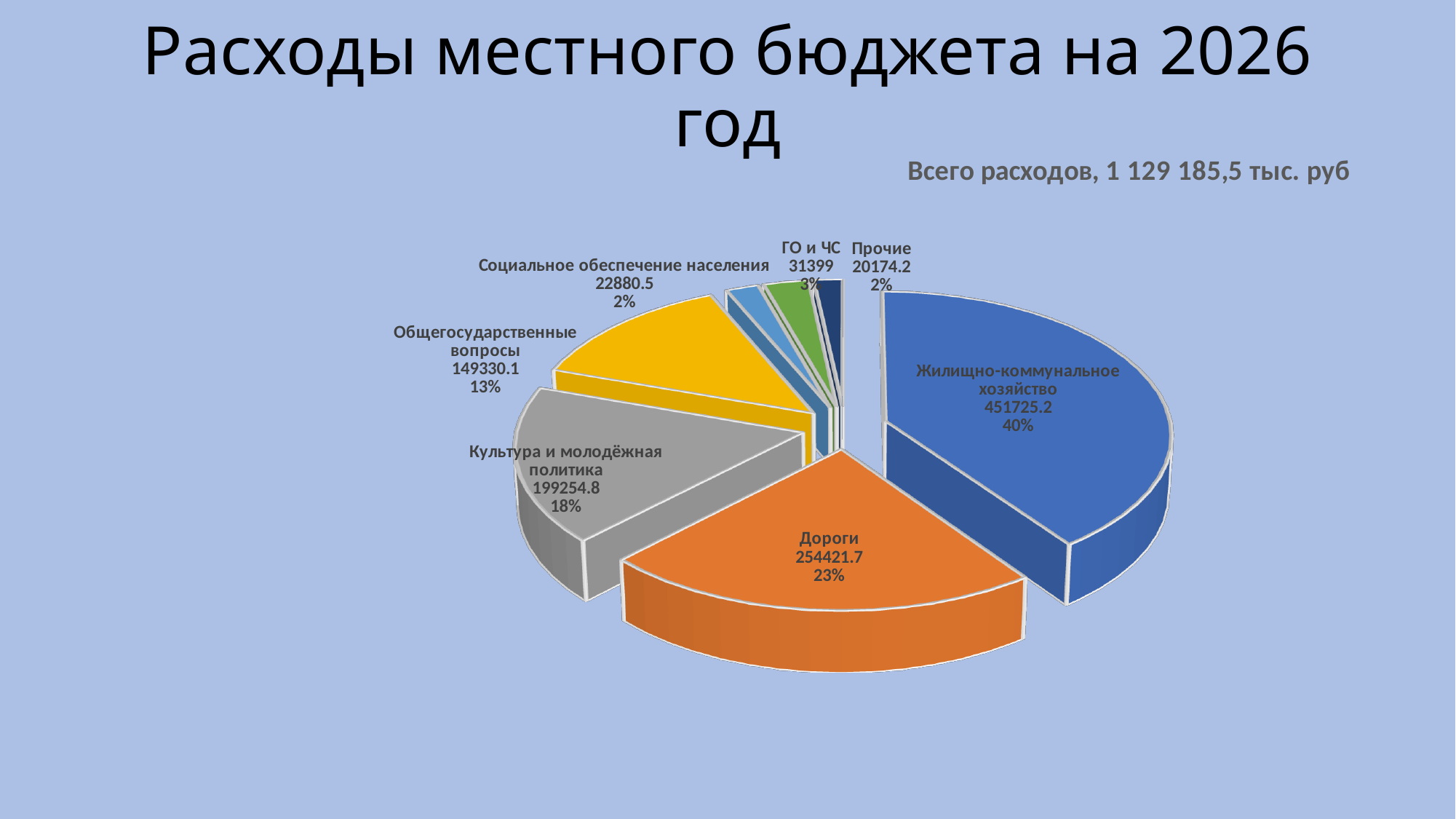
What is the difference between the values for Дороги and Культура и молодёжная политика? 55166.9 What is the title of the slide? Расходы местного бюджета на 2026 год Which is larger, the value for ГО и ЧС or the value for Прочие? ГО и ЧС What percentage share does the Дороги slice have? 23% What percentage share does Общегосударственные вопросы have? 13% What is the value shown for ГО и ЧС? 31399 What kind of chart is shown on the slide? Pie chart What is the value shown for Жилищно-коммунальное хозяйство? 451725.2 What total expenditure amount is stated on the slide? 1 129 185,5 тыс. руб Which category has the largest slice of the pie? Жилищно-коммунальное хозяйство What is the difference between the values for Жилищно-коммунальное хозяйство and Дороги? 197303.5 What is the value shown for Культура и молодёжная политика? 199254.8